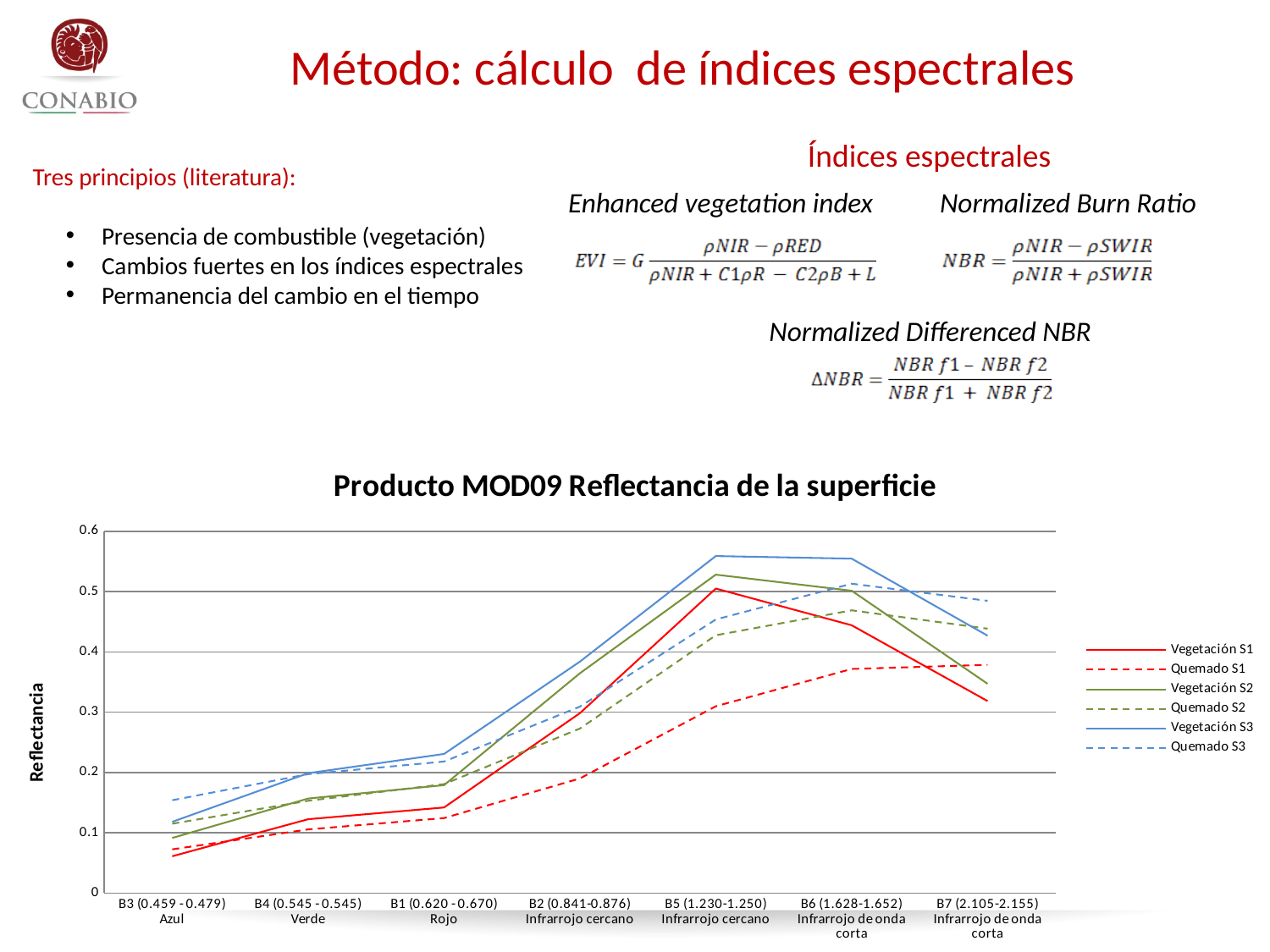
Is the value for Quemado S1 at B3 (0.459 -0.479) greater or less than 0.1? less Is the value for Quemado S1 at B6 (1.628-1.652) greater or less than 0.4? less How many spectral bands (categories) are plotted along the x axis? 7 Which series has the highest value at B5 (1.230-1.250)? Vegetación S3 At B7 (2.105-2.155), which is larger: Quemado S3 or Vegetación S1? Quemado S3 Does the Vegetación S1 line rise or fall from B5 (1.230-1.250) to B7 (2.105-2.155)? fall Which series has the lowest value at B5 (1.230-1.250)? Quemado S1 What kind of chart is shown on the slide? line chart What is the title of the chart? Producto MOD09 Reflectancia de la superficie Is the value for Vegetación S3 at B5 (1.230-1.250) greater or less than 0.5? greater How many series does the chart legend list? 6 What is the label of the vertical axis? Reflectancia